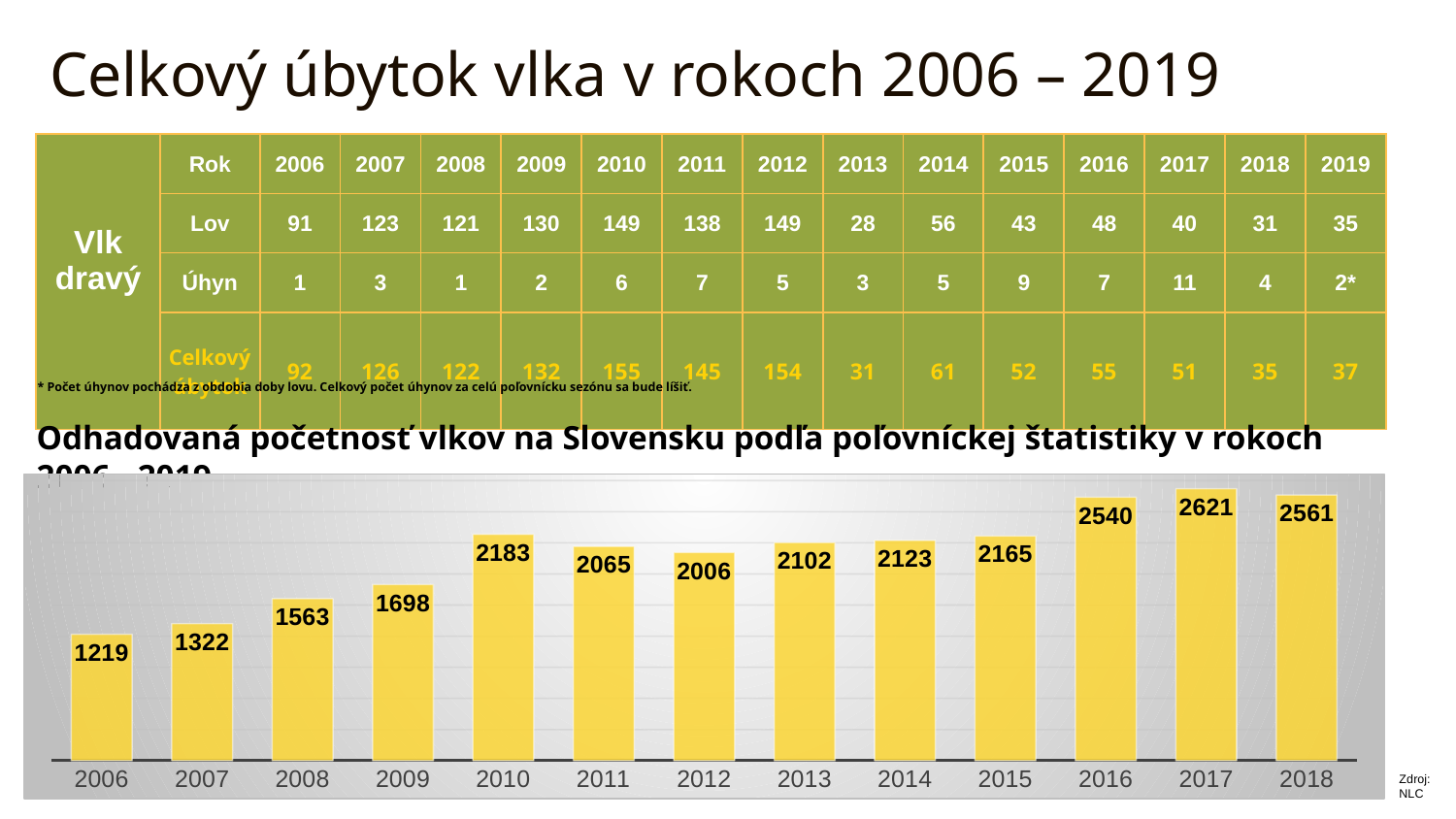
In the bar chart at the bottom of the slide, what is the value for 2006? 1219 In the bar chart at the bottom of the slide, which year has the highest value? 2017 In the bar chart at the bottom of the slide, which year has the lowest value? 2006 In the bar chart at the bottom of the slide, what is the difference between the values for 2017 and 2006? 1402 In the bar chart at the bottom of the slide, what is the value for 2010? 2183 In the bar chart at the bottom of the slide, what is the difference between the values for 2007 and 2006? 103 How many years (bars) are shown in the bar chart at the bottom of the slide? 13 In the bar chart at the bottom of the slide, which is larger, the value for 2012 or the value for 2013? 2013 In the bar chart at the bottom of the slide, what is the value for 2016? 2540 What kind of chart is shown at the bottom of the slide? bar chart In the bar chart at the bottom of the slide, which is larger, the value for 2010 or the value for 2011? 2010 In the bar chart at the bottom of the slide, do the values rise or fall from 2006 to 2010? rise